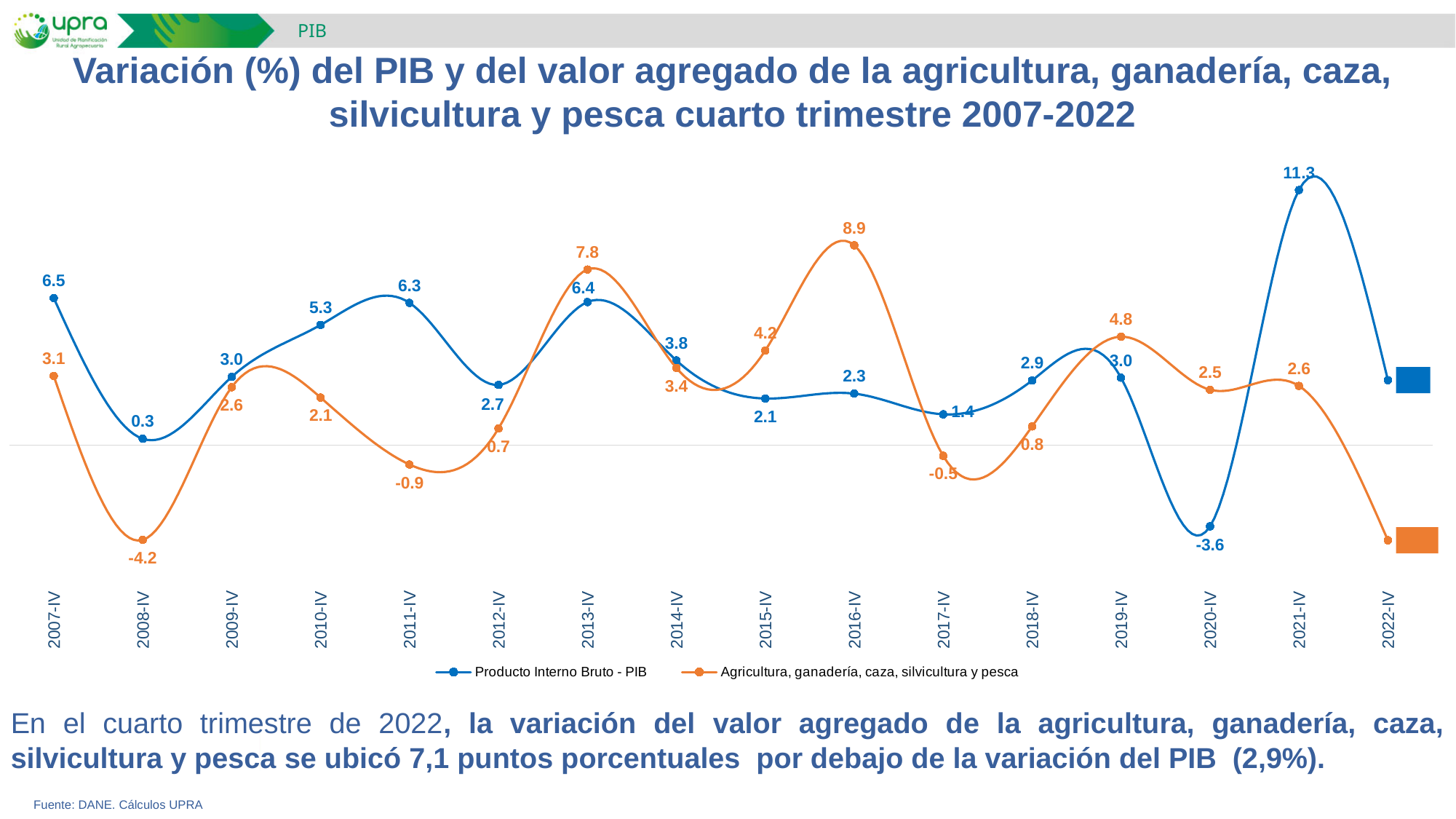
Does the Agricultura, ganadería, caza, silvicultura y pesca series rise or fall from 2014-IV to 2016-IV? Rise In which period does the Producto Interno Bruto - PIB series reach its lowest value? 2020-IV Which colour is used for the Producto Interno Bruto - PIB series? Blue In 2015-IV, which series has the larger value, PIB or Agricultura, ganadería, caza, silvicultura y pesca? Agricultura, ganadería, caza, silvicultura y pesca What is the difference between the Agricultura value and the PIB value in 2016-IV? 6.6 What kind of chart is shown on the slide? Line chart What is the value of Producto Interno Bruto - PIB for 2021-IV? 11.3 What is the value of Producto Interno Bruto - PIB for 2020-IV? -3.6 How many series does the legend list? 2 What is the value of Agricultura, ganadería, caza, silvicultura y pesca for 2008-IV? -4.2 How many periods are shown on the x axis? 16 In which period does the Agricultura, ganadería, caza, silvicultura y pesca series reach its highest value? 2016-IV